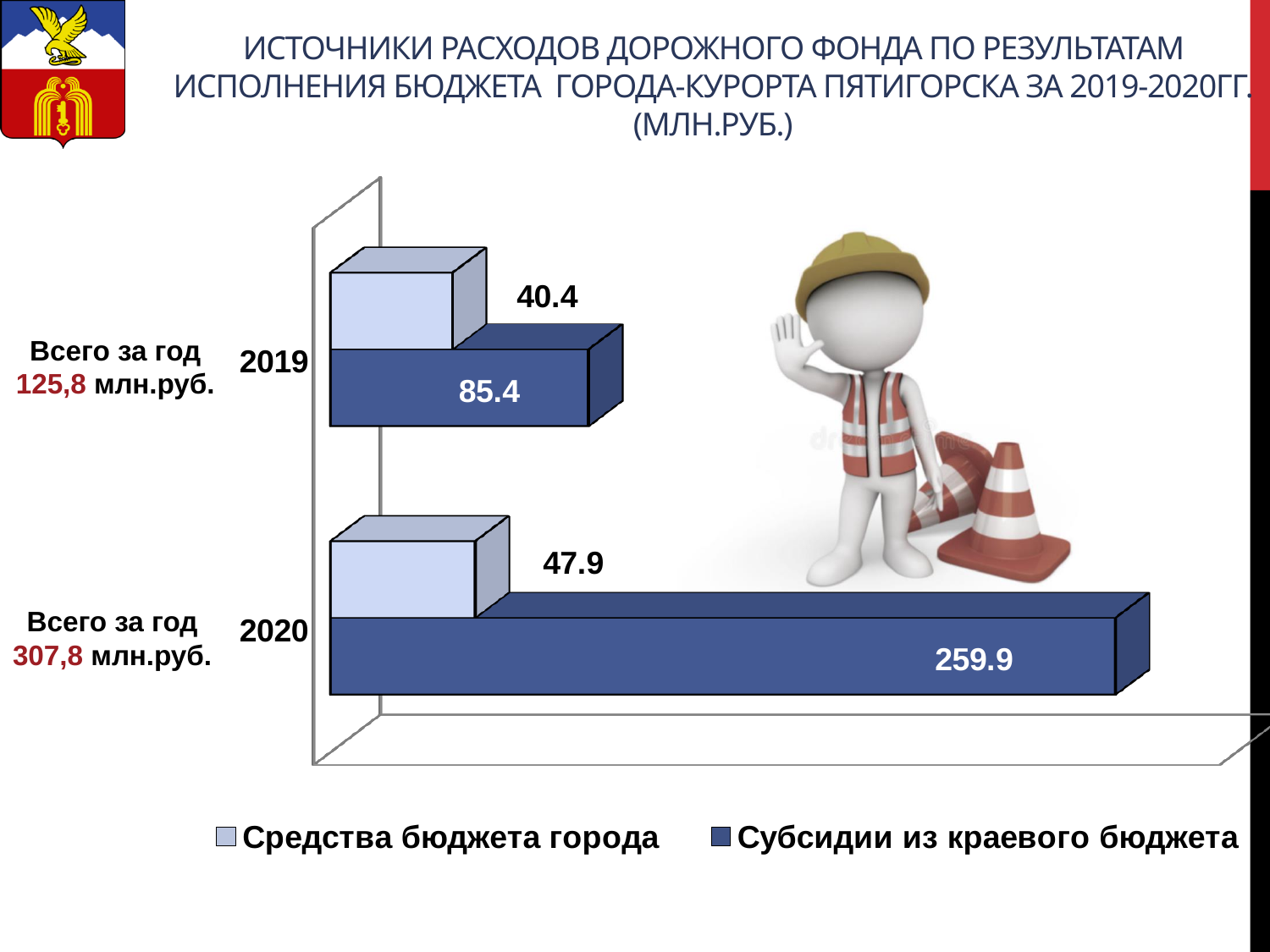
What is the difference between Средства бюджета города in 2020 and in 2019? 7.5 What is the difference between Субсидии из краевого бюджета in 2020 and in 2019? 174.5 In 2019, which is larger: Средства бюджета города or Субсидии из краевого бюджета? Субсидии из краевого бюджета What is the value for Субсидии из краевого бюджета in 2019? 85.4 What is the value for Средства бюджета города in 2020? 47.9 What is the value for Субсидии из краевого бюджета in 2020? 259.9 Which year has the lower value for Средства бюджета города? 2019 What kind of chart is shown on the slide? Bar chart What is the value for Средства бюджета города in 2019? 40.4 How many years (categories) are shown on the chart? 2 Which year has the higher value for Субсидии из краевого бюджета? 2020 How many series does the legend list? 2